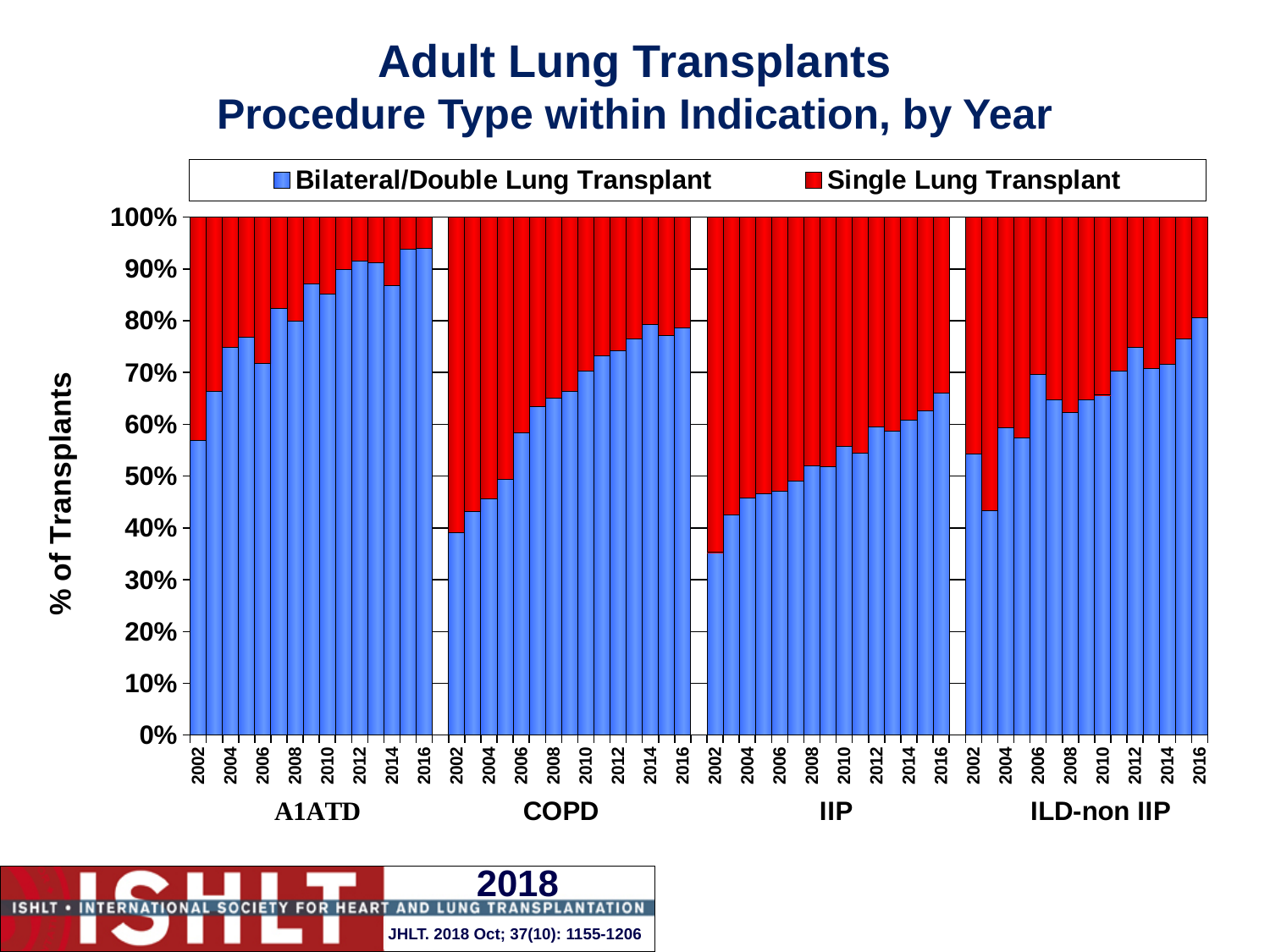
Which two procedure types are listed in the legend? Bilateral/Double Lung Transplant and Single Lung Transplant What kind of chart is shown on the slide? Stacked bar chart How many indication groups are shown along the x axis? 4 For 2016, which group has the larger Bilateral/Double Lung Transplant share: A1ATD or COPD? A1ATD In the ILD-non IIP group, is the Bilateral/Double Lung Transplant share for 2003 greater or less than 50%? less In the IIP group, is the Bilateral/Double Lung Transplant share for 2002 greater or less than 40%? less In the A1ATD group, is the Bilateral/Double Lung Transplant share for 2016 greater or less than 90%? greater In the COPD group, does the Bilateral/Double Lung Transplant share generally rise or fall from 2002 to 2016? rise What is the label of the y axis? % of Transplants How many series does the legend list? 2 In the COPD group, which year has the lowest Bilateral/Double Lung Transplant share? 2002